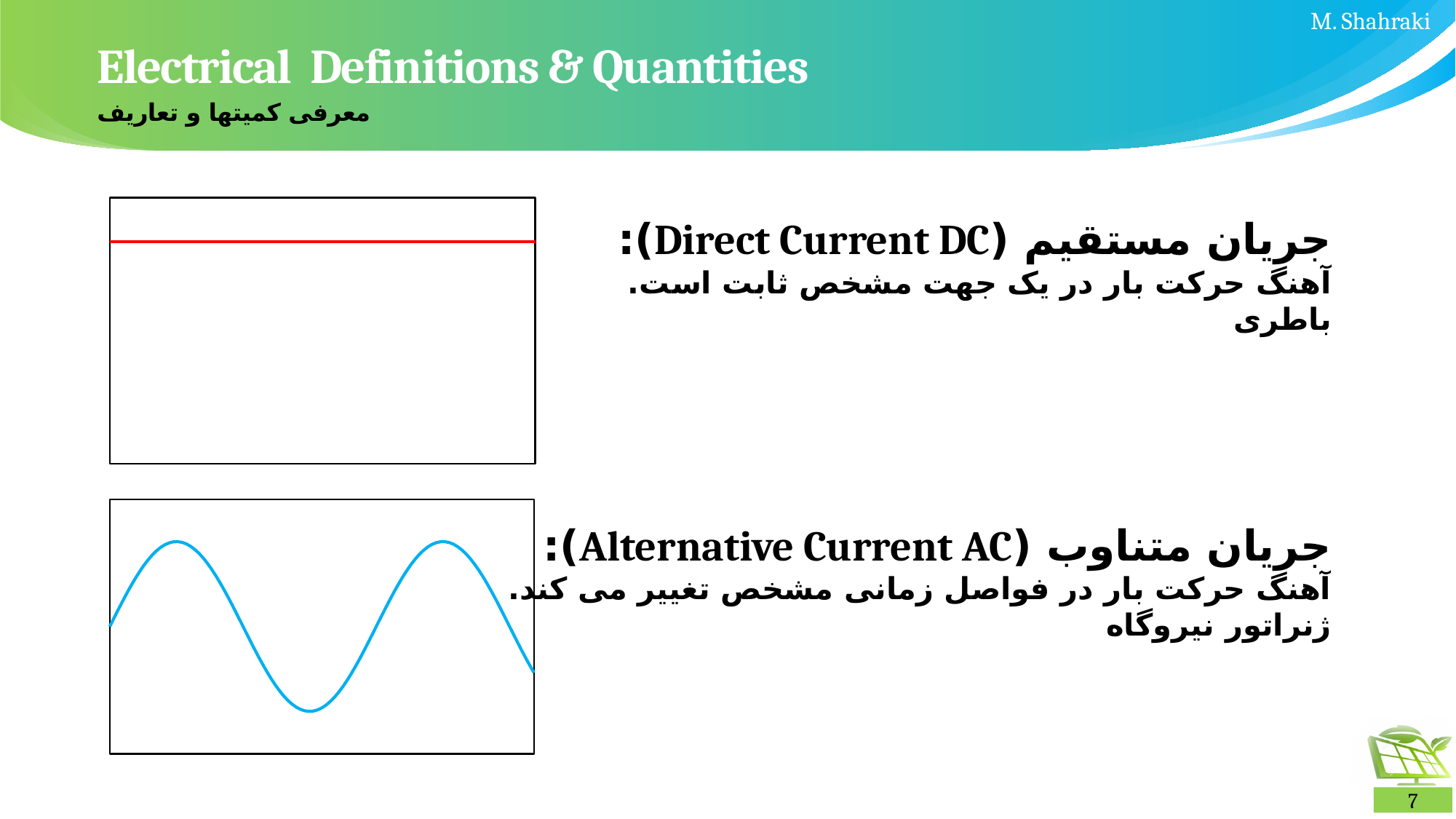
How many lines are plotted in the top chart? 1 How many charts are shown on the slide? 2 What colour is the line in the bottom chart? blue In the top chart, does the plotted line rise, fall, or stay constant along the x axis? stays constant How many lines are plotted in the bottom chart? 1 How many peaks does the wave in the bottom chart show? 2 What kind of chart is the top chart on the slide? line chart What kind of chart is the bottom chart on the slide? line chart What colour is the line in the top chart? red In the bottom chart, does the plotted line stay constant or rise and fall along the x axis? rises and falls